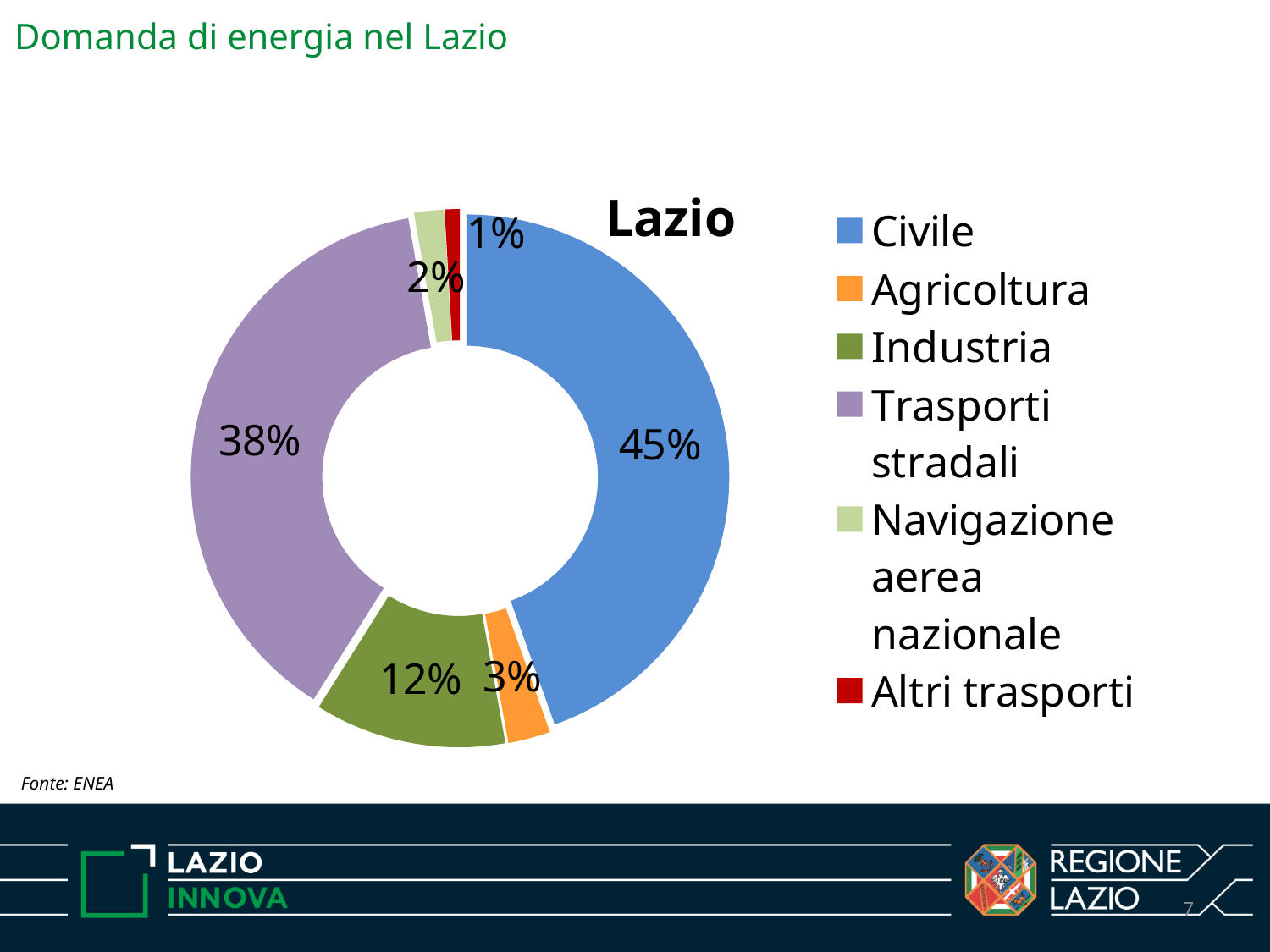
Which is larger, the share for Industria or the share for Agricoltura? Industria What percentage is shown for Agricoltura? 3% How many categories does the legend list? 6 What percentage is shown for Navigazione aerea nazionale? 2% Which category has the largest share of energy demand in Lazio? Civile Which category has the smallest share of energy demand in Lazio? Altri trasporti What share of energy demand does Civile account for in the Lazio chart? 45% What is the difference in percentage points between Civile and Trasporti stradali? 7 What kind of chart is shown on the slide? Doughnut (pie) chart What percentage is shown for Trasporti stradali? 38% What percentage is shown for Industria? 12% What is the title shown on the chart? Lazio